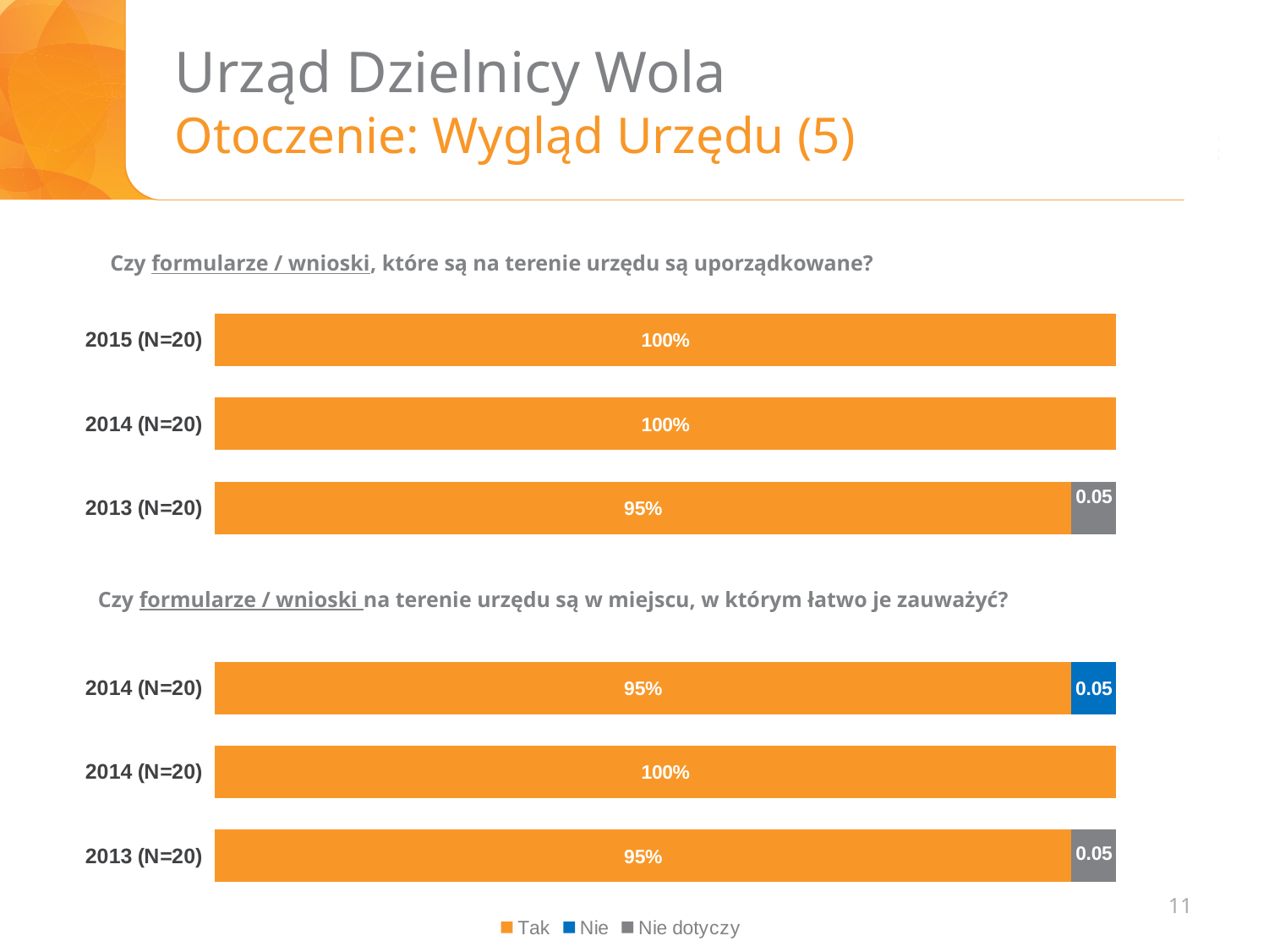
In the top chart ("Czy formularze / wnioski, które są na terenie urzędu są uporządkowane?"), what is the "Tak" value for 2013 (N=20)? 95% How many bars (year categories) does the top chart ("Czy formularze / wnioski, które są na terenie urzędu są uporządkowane?") show? 3 In the bottom chart ("Czy formularze / wnioski na terenie urzędu są w miejscu, w którym łatwo je zauważyć?"), what value is shown in the blue "Nie" segment of the topmost bar? 0.05 In the bottom chart ("Czy formularze / wnioski na terenie urzędu są w miejscu, w którym łatwo je zauważyć?"), is the "Tak" value for the middle bar larger or smaller than the "Tak" value for 2013 (N=20)? larger How many series does the legend at the bottom of the slide list? 3 In the bottom chart ("Czy formularze / wnioski na terenie urzędu są w miejscu, w którym łatwo je zauważyć?"), what is the "Tak" value for 2013 (N=20)? 95% In the top chart ("Czy formularze / wnioski, które są na terenie urzędu są uporządkowane?"), what value is shown in the grey "Nie dotyczy" segment for 2013 (N=20)? 0.05 In the top chart ("Czy formularze / wnioski, które są na terenie urzędu są uporządkowane?"), what is the "Tak" value for 2015 (N=20)? 100% What type of chart is used on this slide? Stacked horizontal bar chart In the top chart ("Czy formularze / wnioski, które są na terenie urzędu są uporządkowane?"), what is the difference between the "Tak" value for 2014 (N=20) and for 2013 (N=20)? 5% In the bottom chart ("Czy formularze / wnioski na terenie urzędu są w miejscu, w którym łatwo je zauważyć?"), what is the "Tak" value for the middle bar? 100% In the top chart ("Czy formularze / wnioski, które są na terenie urzędu są uporządkowane?"), which year has the lowest "Tak" value? 2013 (N=20)